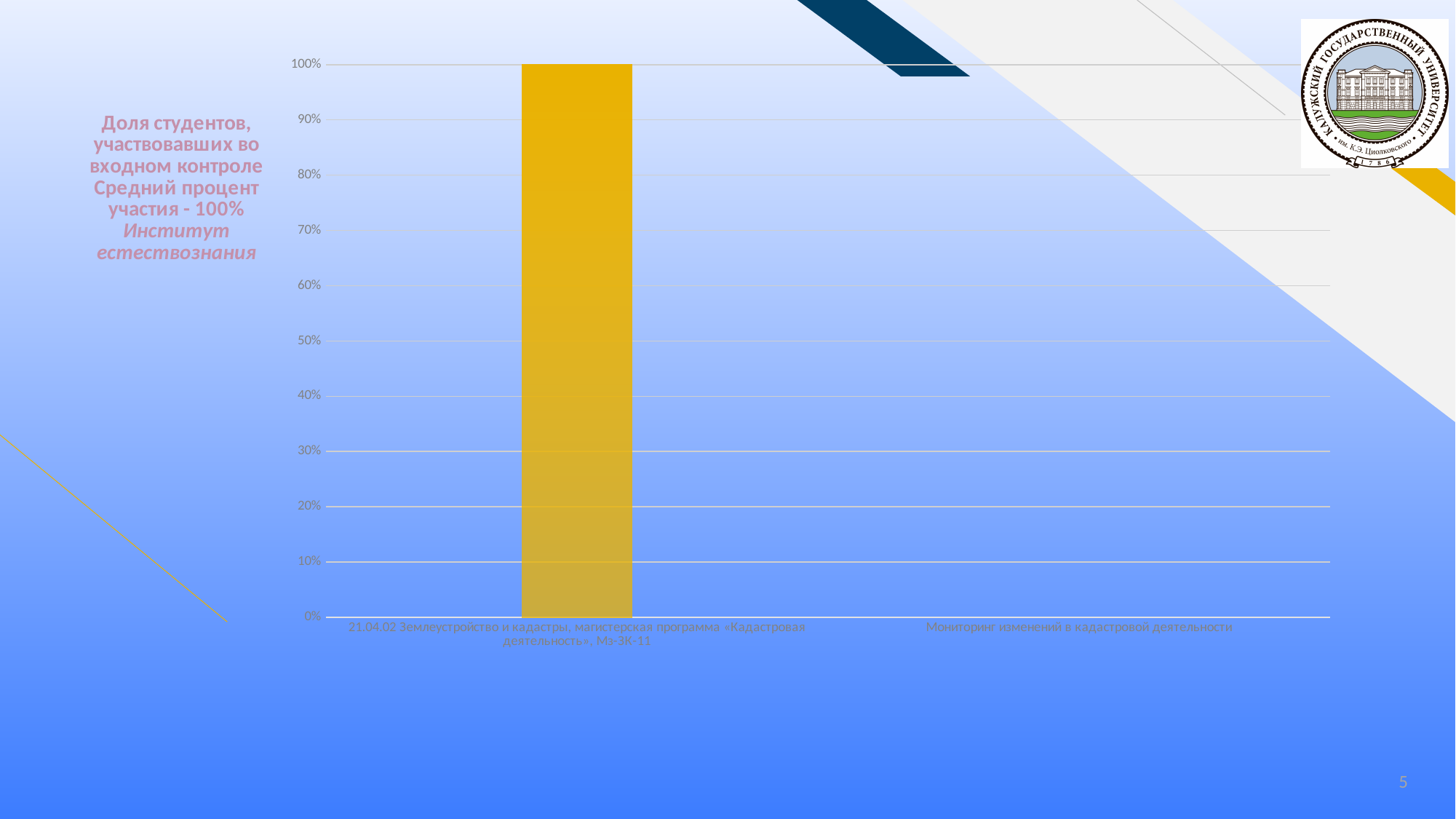
What is the value of the bar for "21.04.02 Землеустройство и кадастры, магистерская программа «Кадастровая деятельность», Мз-ЗК-11"? 100% What is the average participation percentage stated in the text next to the chart? 100% Is the value for "21.04.02 Землеустройство и кадастры, магистерская программа «Кадастровая деятельность», Мз-ЗК-11" greater or less than 50%? greater What kind of chart is shown on the slide? bar chart What is the highest value shown on the y axis of the chart? 100% Which category has the highest bar in the chart? 21.04.02 Землеустройство и кадастры, магистерская программа «Кадастровая деятельность», Мз-ЗК-11 How many categories are shown on the x axis of the chart? 2 What is the label of the second category on the x axis? Мониторинг изменений в кадастровой деятельности